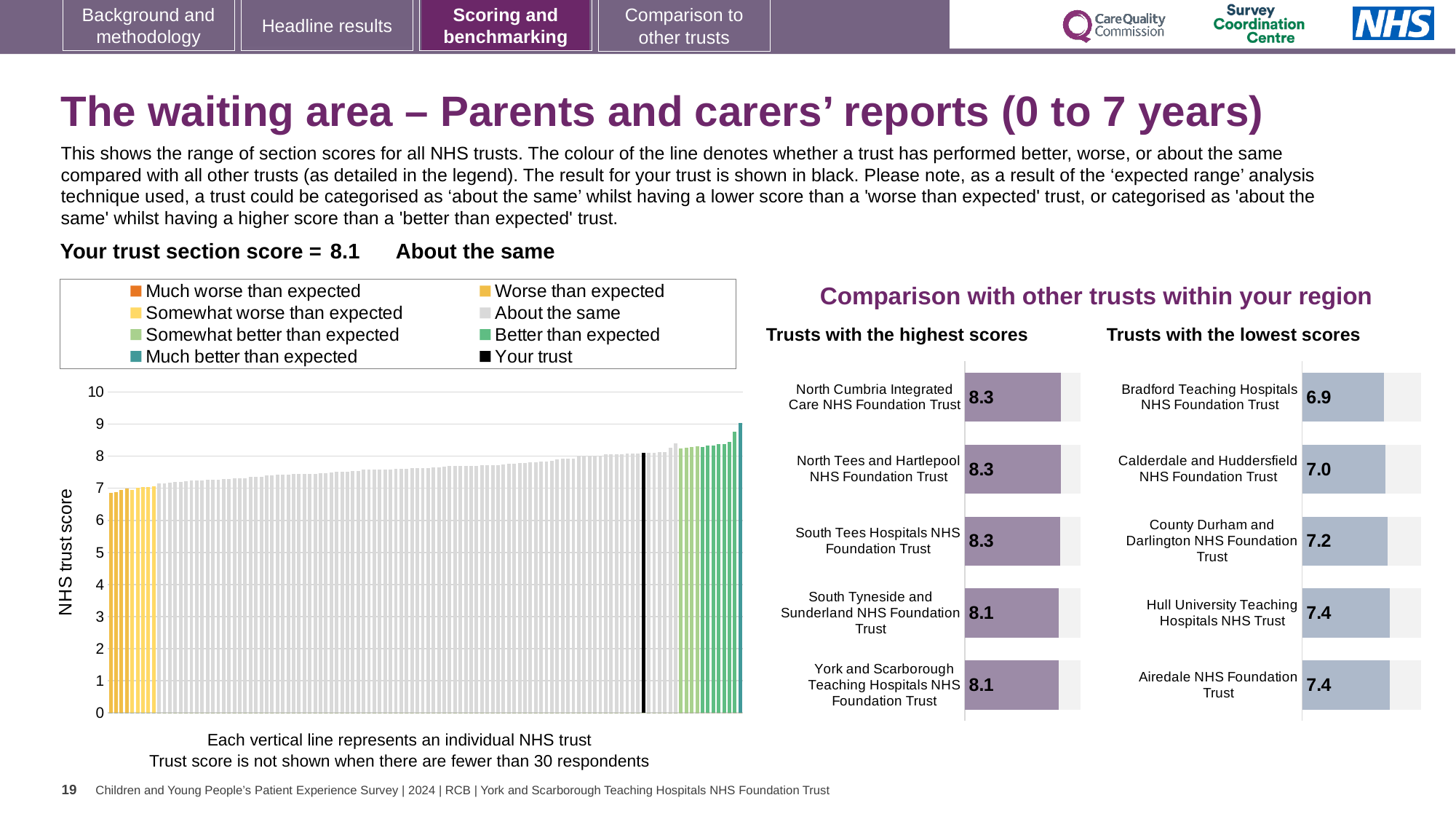
In the main 'NHS trust score' chart, is the value of the leftmost bar greater or less than 8? less In the 'Trusts with the lowest scores' chart, which trust has the lowest score? Bradford Teaching Hospitals NHS Foundation Trust In the 'Trusts with the lowest scores' chart, which has the higher score: Calderdale and Huddersfield NHS Foundation Trust or County Durham and Darlington NHS Foundation Trust? County Durham and Darlington NHS Foundation Trust How many trusts are listed in the 'Trusts with the highest scores' chart? 5 How many entries does the legend of the main 'NHS trust score' chart list? 8 In the 'Trusts with the lowest scores' chart, what is the score for Bradford Teaching Hospitals NHS Foundation Trust? 6.9 In the 'Trusts with the highest scores' chart, what is the score for North Cumbria Integrated Care NHS Foundation Trust? 8.3 In the 'Trusts with the lowest scores' chart, what is the difference between the scores of Hull University Teaching Hospitals NHS Trust and Bradford Teaching Hospitals NHS Foundation Trust? 0.5 In the 'Trusts with the highest scores' chart, what is the score for York and Scarborough Teaching Hospitals NHS Foundation Trust? 8.1 What kind of chart is the main chart with the 'NHS trust score' axis? Bar chart In the main 'NHS trust score' chart, do the bar values rise or fall from left to right? Rise In the 'Trusts with the highest scores' chart, what is the difference between the scores of South Tees Hospitals NHS Foundation Trust and South Tyneside and Sunderland NHS Foundation Trust? 0.2